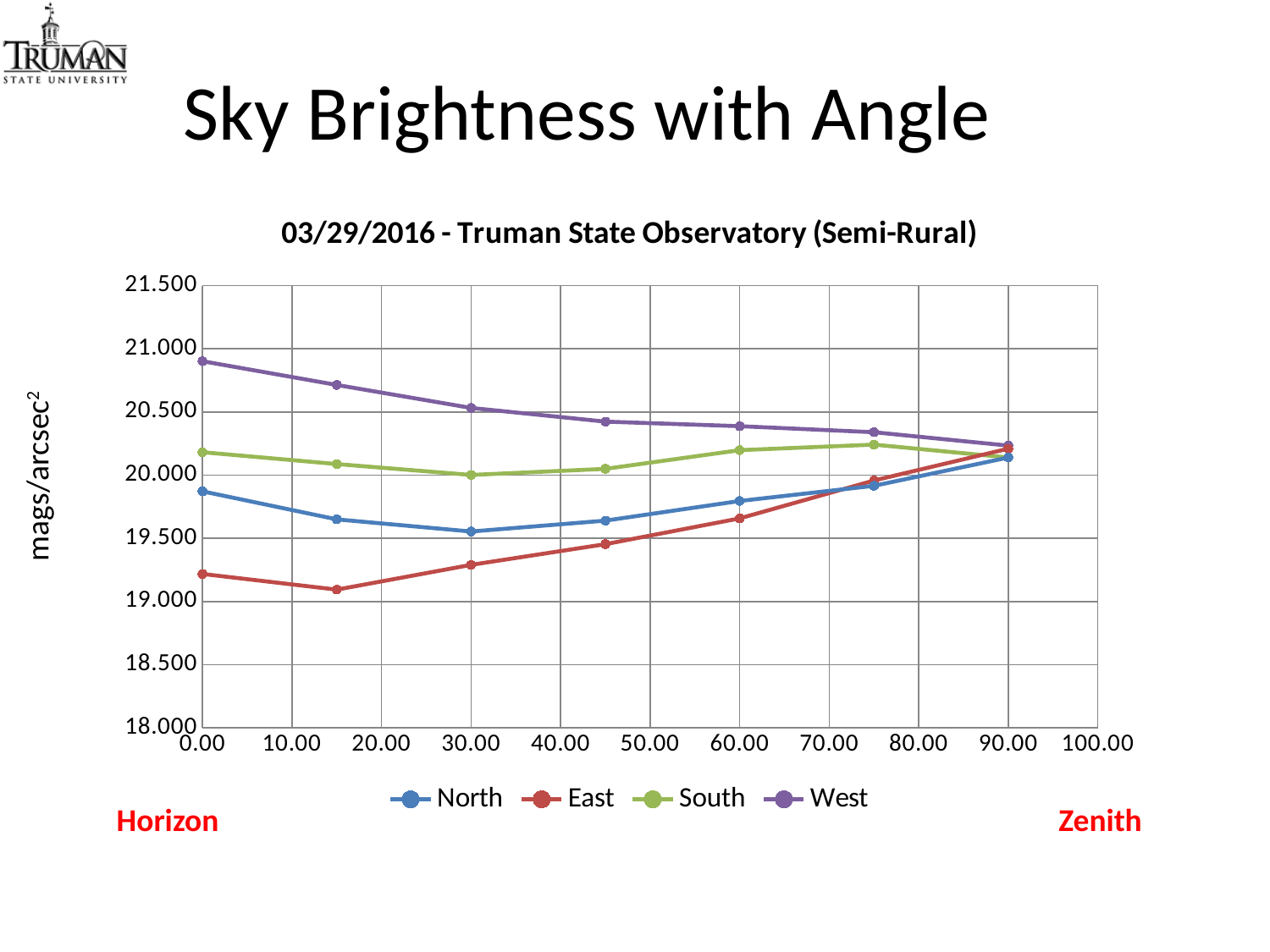
What is the title of the chart? 03/29/2016 - Truman State Observatory (Semi-Rural) Which series has the highest value at 0.00? West Which series has the lowest value at 0.00? East How many series does the legend list? 4 What kind of chart is shown on the slide? line chart How many data points are plotted for the West series? 7 At 30.00, which is larger, the North value or the East value? North Is the value for East at 15.00 greater or less than 19.500? less Is the value for North at 30.00 greater or less than 20.000? less Does the West series rise or fall from 0.00 to 90.00? fall Is the value for West at 0.00 greater or less than 20.500? greater Does the East series generally rise or fall from 15.00 to 90.00? rise